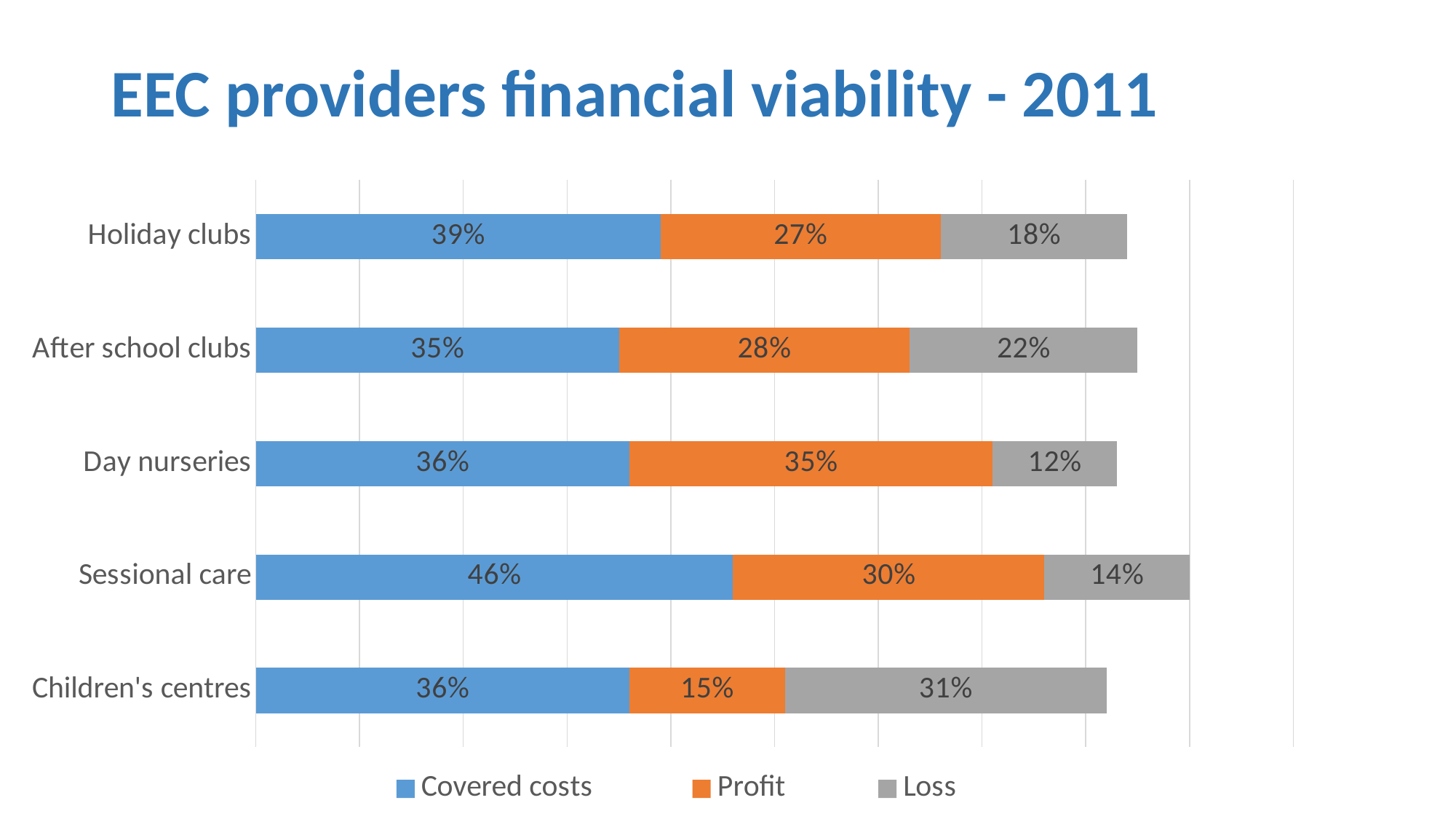
Which provider type has the highest Covered costs value? Sessional care What kind of chart is shown on the slide? Stacked bar chart What is the difference between the Loss values for After school clubs and Holiday clubs? 4% What is the total of the three segments for Sessional care? 90% What percentage of Holiday clubs covered costs? 39% What is the Loss value for Children's centres? 31% How many provider types are shown on the chart? 5 Which provider type has the lowest Loss value? Day nurseries Which is larger, the Profit value for Sessional care or the Profit value for After school clubs? Sessional care How many series does the legend list? 3 Which provider type has the lowest Profit value? Children's centres What is the Profit value for Day nurseries? 35%